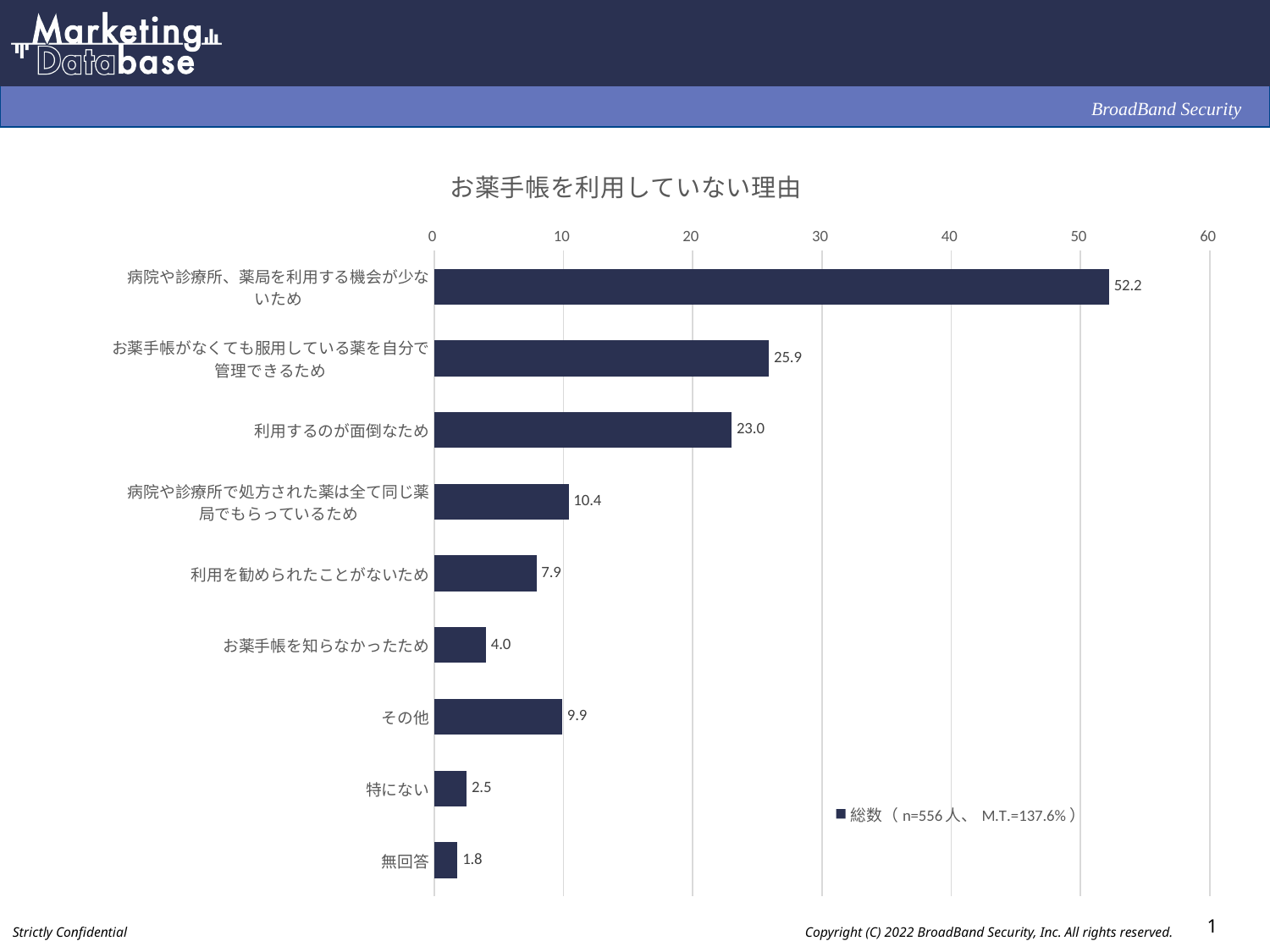
How many categories are shown in the chart? 9 Which category has the lowest value? 無回答 How many series does the legend list? 1 Which category has the highest value? 病院や診療所、薬局を利用する機会が少ないため What kind of chart is shown on the slide? bar chart What is the value for 病院や診療所、薬局を利用する機会が少ないため? 52.2 What is the difference between the values for お薬手帳がなくても服用している薬を自分で管理できるため and 利用するのが面倒なため? 2.9 What is the title of the chart? お薬手帳を利用していない理由 What is the value for お薬手帳を知らなかったため? 4.0 Which is larger, the value for 病院や診療所で処方された薬は全て同じ薬局でもらっているため or the value for その他? 病院や診療所で処方された薬は全て同じ薬局でもらっているため Is the value for 利用を勧められたことがないため greater or less than 10? less What is the value for 利用するのが面倒なため? 23.0